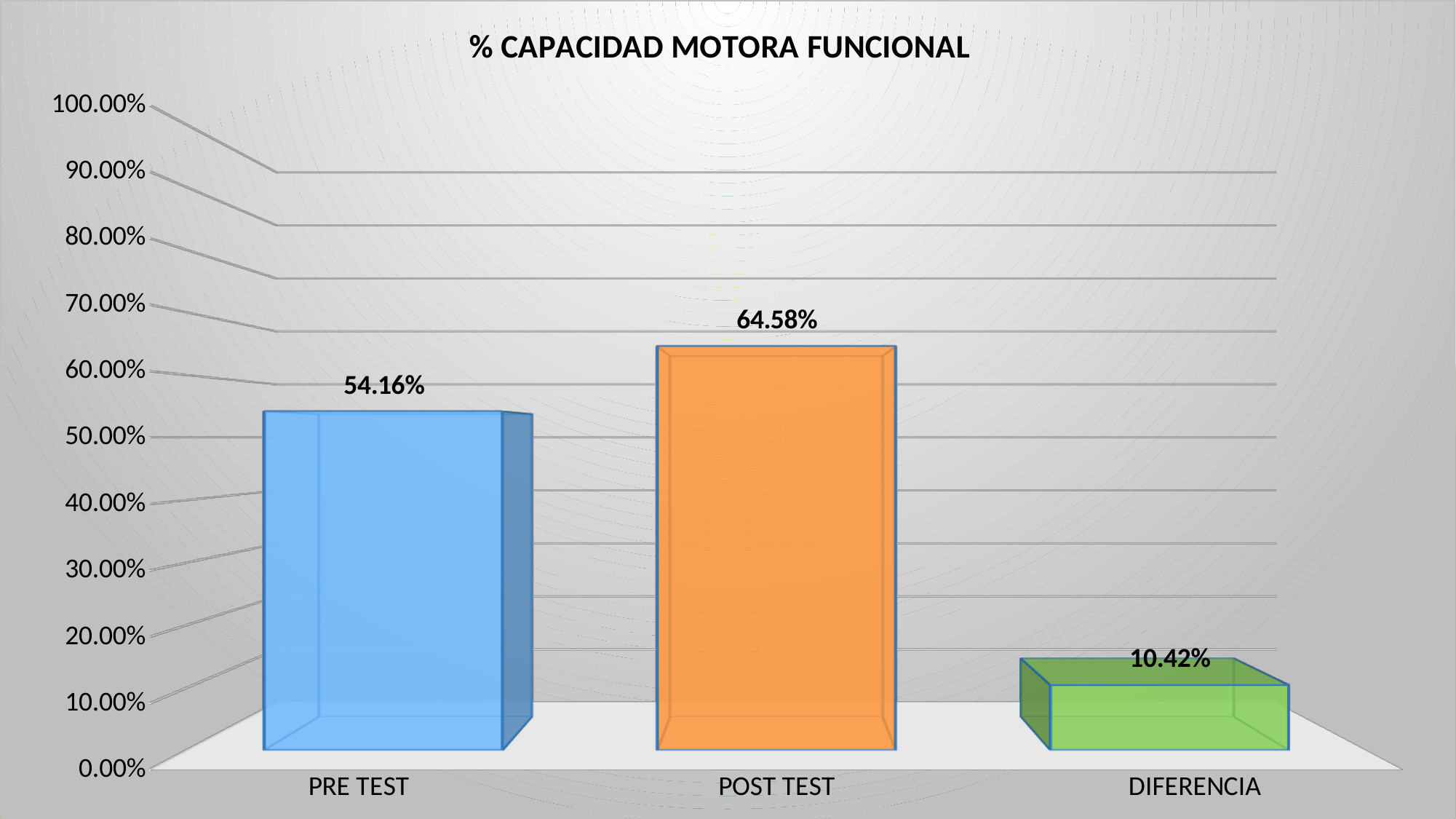
What is the value for POST TEST? 64.58% How many categories are shown on the x axis? 3 What is the difference between the POST TEST and PRE TEST values? 10.42% Which category has the lowest value? DIFERENCIA What is the title of the chart? % CAPACIDAD MOTORA FUNCIONAL What kind of chart is shown on the slide? bar chart What is the value for DIFERENCIA? 10.42% Which is larger, the value for PRE TEST or the value for POST TEST? POST TEST Which category has the highest value? POST TEST Is the value for DIFERENCIA greater or less than 20.00%? less Is the value for PRE TEST greater or less than 50.00%? greater What is the value for PRE TEST? 54.16%